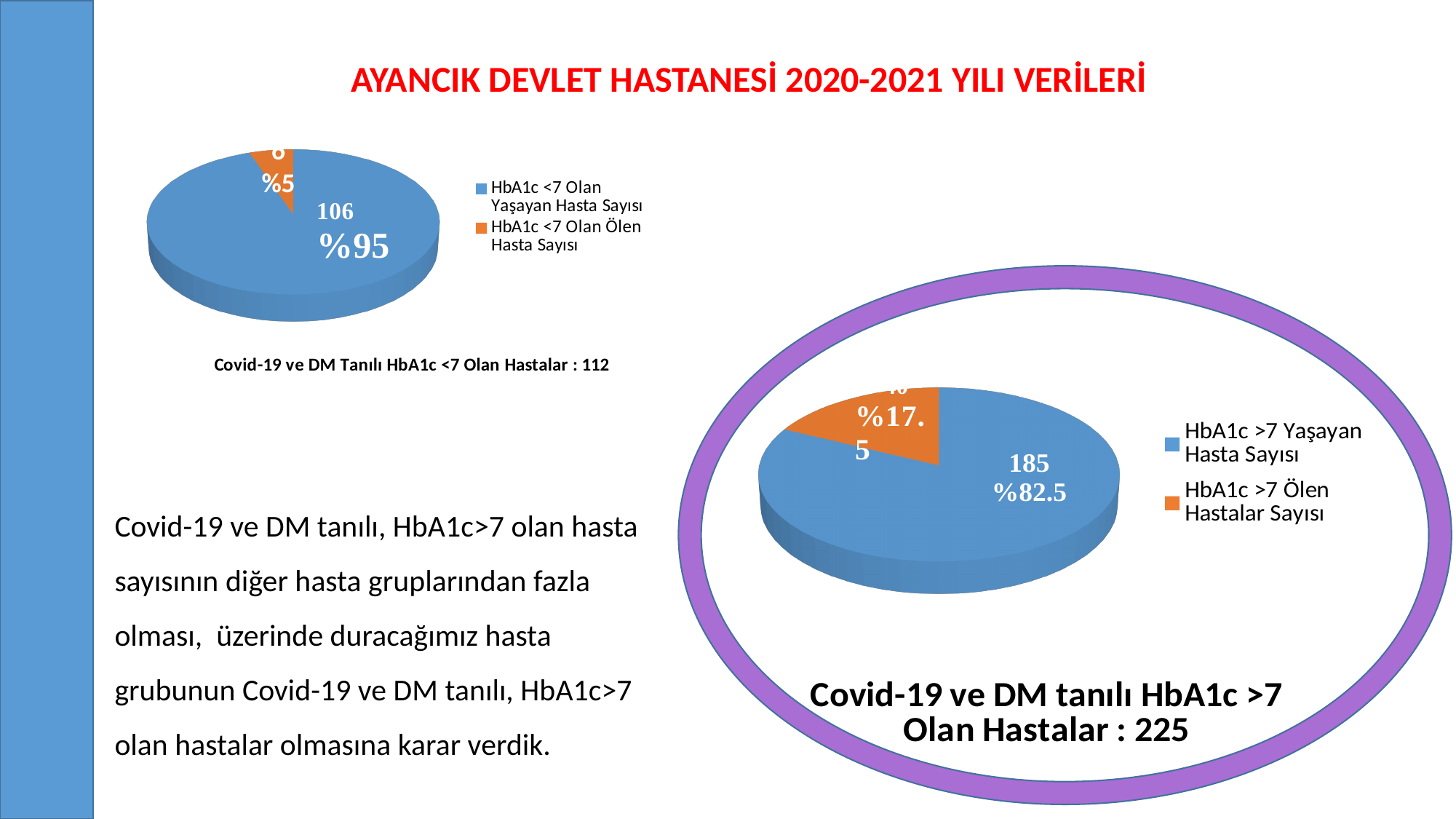
In the chart titled "Covid-19 ve DM Tanılı HbA1c <7 Olan Hastalar : 112", which category has the largest slice? HbA1c <7 Olan Yaşayan Hasta Sayısı How many entries does the legend list in the chart titled "Covid-19 ve DM Tanılı HbA1c <7 Olan Hastalar : 112"? 2 In the chart titled "Covid-19 ve DM tanılı HbA1c >7 Olan Hastalar : 225", what percentage share does the HbA1c >7 Ölen Hastalar Sayısı slice have? %17.5 In the chart titled "Covid-19 ve DM tanılı HbA1c >7 Olan Hastalar : 225", what colour is the HbA1c >7 Ölen Hastalar Sayısı slice? Orange In the chart titled "Covid-19 ve DM tanılı HbA1c >7 Olan Hastalar : 225", which category has the smallest slice? HbA1c >7 Ölen Hastalar Sayısı What kind of chart is the chart titled "Covid-19 ve DM Tanılı HbA1c <7 Olan Hastalar : 112"? Pie chart In the chart titled "Covid-19 ve DM Tanılı HbA1c <7 Olan Hastalar : 112", what percentage share does the HbA1c <7 Olan Yaşayan Hasta Sayısı slice have? %95 In the chart titled "Covid-19 ve DM tanılı HbA1c >7 Olan Hastalar : 225", what percentage share does the HbA1c >7 Yaşayan Hasta Sayısı slice have? %82.5 In the chart titled "Covid-19 ve DM tanılı HbA1c >7 Olan Hastalar : 225", what is the value for HbA1c >7 Yaşayan Hasta Sayısı? 185 In the chart titled "Covid-19 ve DM Tanılı HbA1c <7 Olan Hastalar : 112", what is the value for HbA1c <7 Olan Yaşayan Hasta Sayısı? 106 Which is larger: the HbA1c <7 Olan Yaşayan Hasta Sayısı value in the left chart or the HbA1c >7 Yaşayan Hasta Sayısı value in the right chart? HbA1c >7 Yaşayan Hasta Sayısı